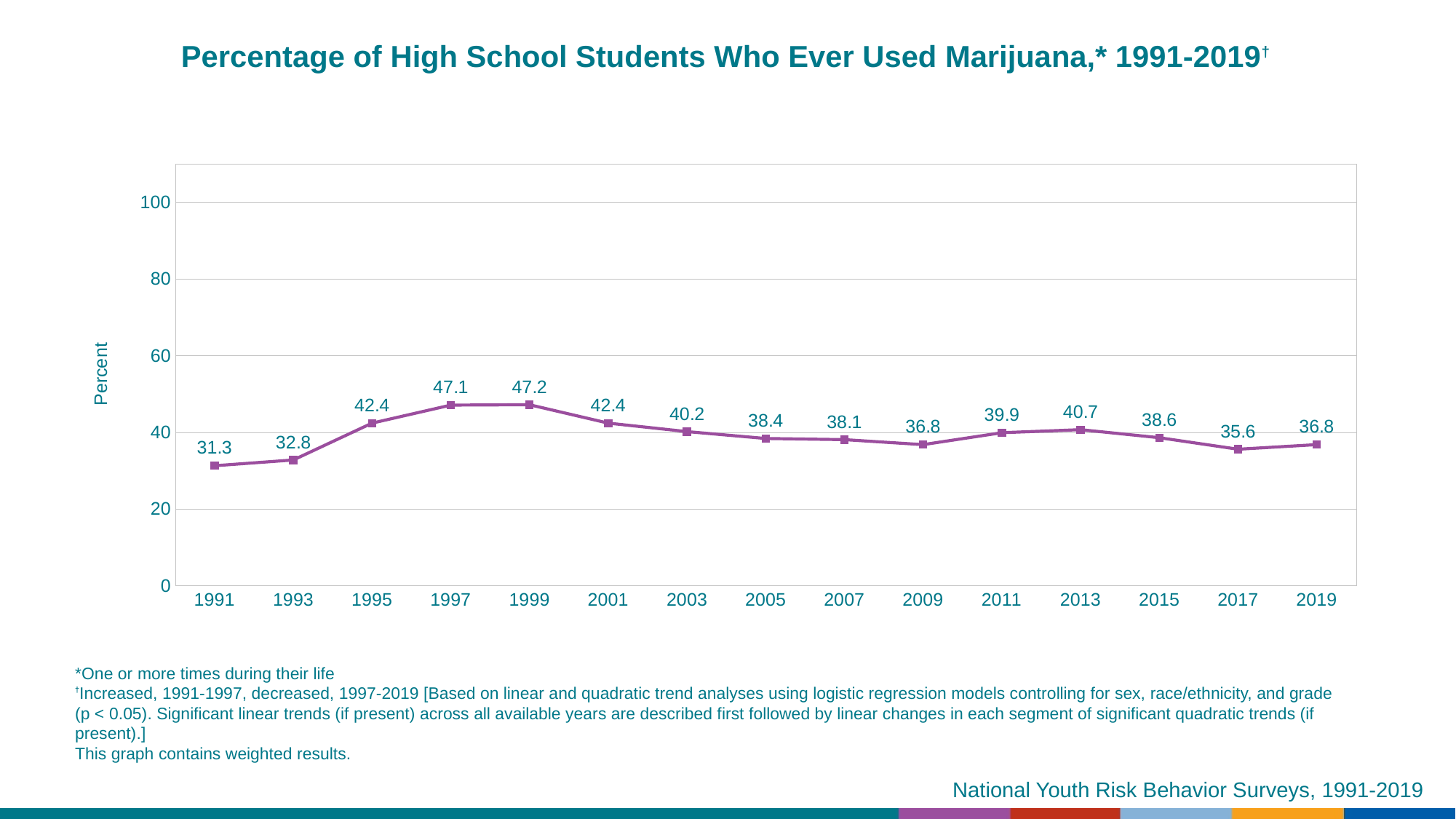
What kind of chart is this? line chart What is the value for 1991? 31.3 What is the difference between the values for 1999 and 1991? 15.9 Which year has the lowest value? 1991 What is the value for 2013? 40.7 Which year has the highest value? 1999 What is the difference between the values for 2017 and 2019? 1.2 What is the value for 2019? 36.8 Do the values rise or fall from 1991 to 1997? rise Is the value for 1997 greater or less than 40? greater Which is larger, the value for 1995 or the value for 2003? 1995 How many years are plotted on the chart? 15